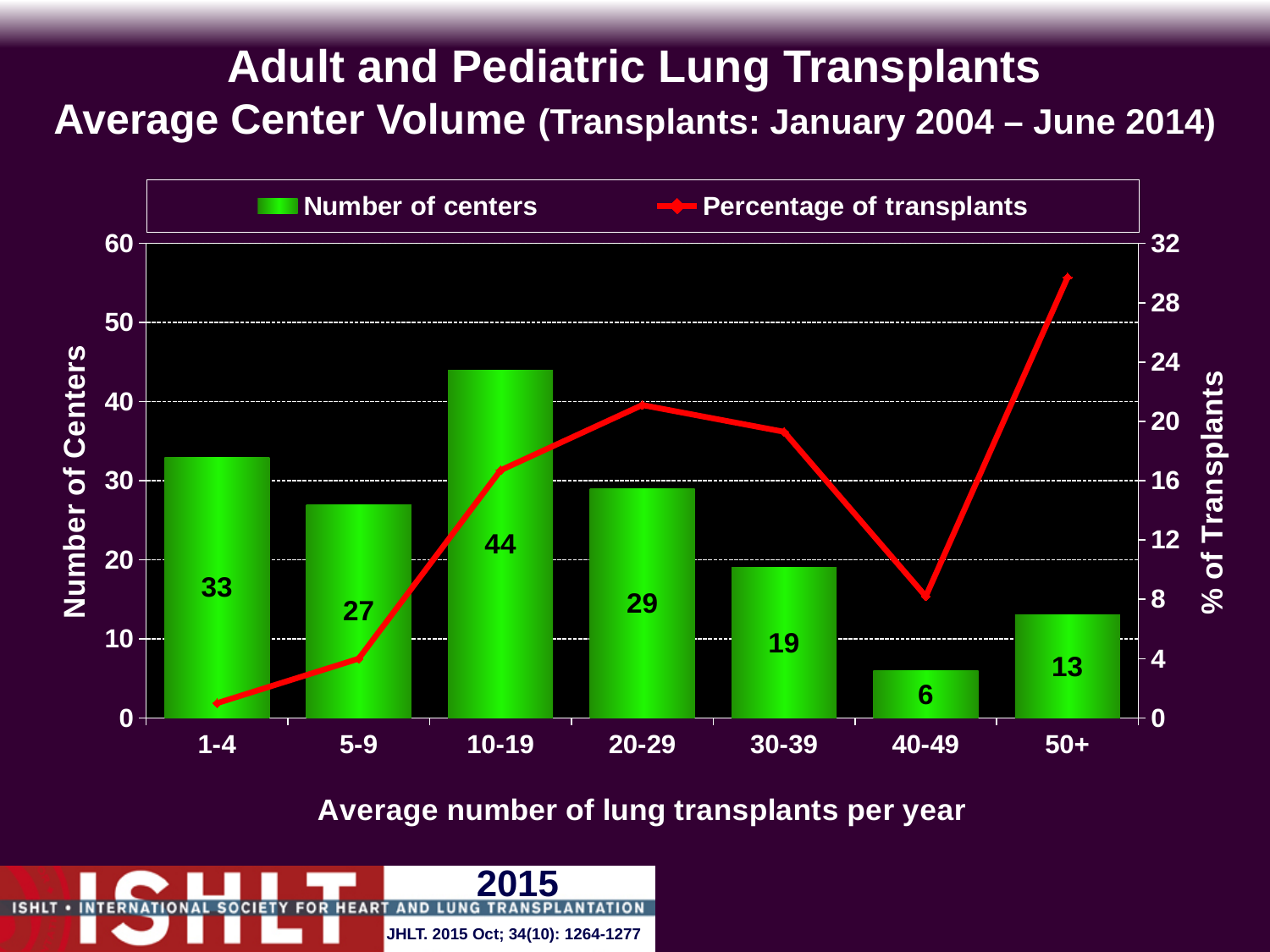
How many categories are shown on the x axis? 7 What is the label of the right-hand vertical axis? % of Transplants Is the percentage of transplants for the 1-4 category greater or less than 4? less What is the number of centers for the 40-49 category? 6 How many series does the legend list? 2 Which category has the lowest number of centers? 40-49 How many centers are in the 10-19 category? 44 Which has more centers, the 1-4 category or the 5-9 category? 1-4 Is the percentage of transplants for the 50+ category greater or less than 28? greater Which category has the highest number of centers? 10-19 What is the number of centers for the 50+ category? 13 What is the difference in number of centers between the 10-19 and 20-29 categories? 15